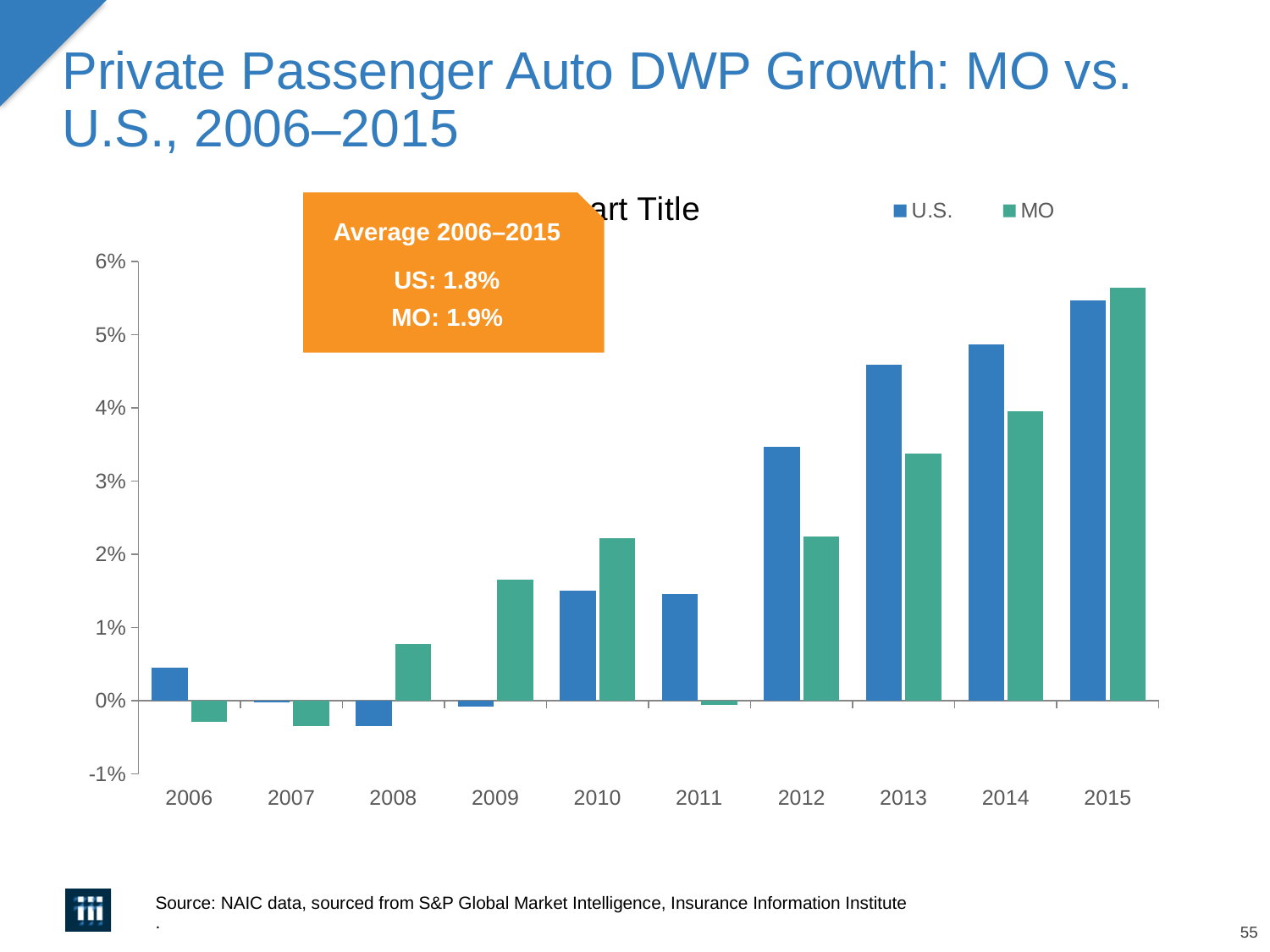
Is the U.S. value for 2015 greater or less than 5%? greater Which year has the highest MO value? 2015 Do the U.S. values generally rise or fall from 2006 to 2015? rise In 2013, which is larger, the U.S. value or the MO value? U.S. Which year has the lowest U.S. value? 2008 What kind of chart is shown on the slide? bar chart How many years are shown on the x axis? 10 According to the text box on the chart, what is the average 2006–2015 growth for MO? 1.9% How many series does the legend list? 2 Is the MO value for 2013 greater or less than 4%? less Which year has the highest U.S. value? 2015 In 2009, which is larger, the U.S. value or the MO value? MO